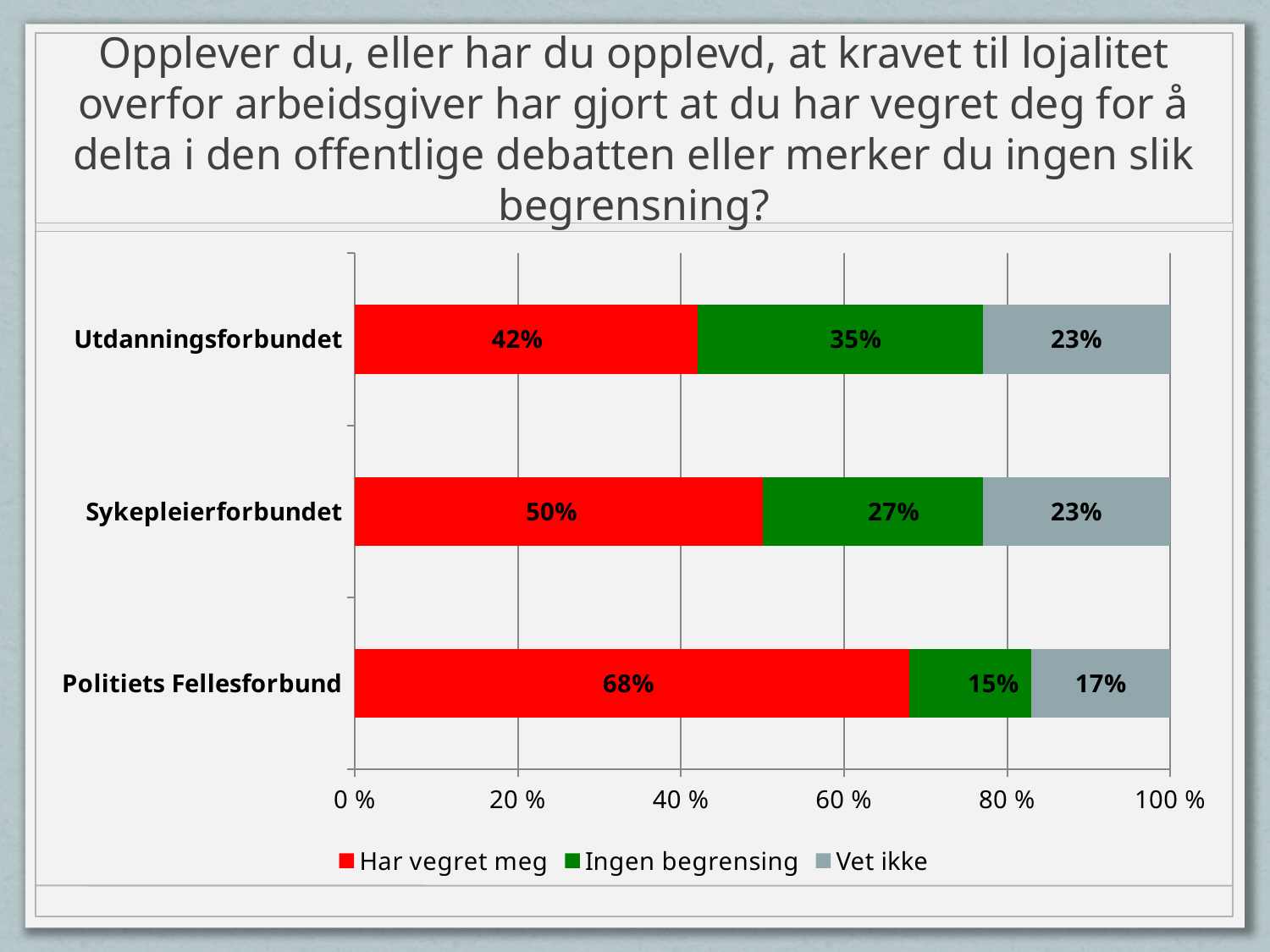
How many series does the legend list? 3 What is the total of the stacked bar for Politiets Fellesforbund? 100% Which category has the lowest value for "Ingen begrensing"? Politiets Fellesforbund Which category has the highest value for "Har vegret meg"? Politiets Fellesforbund What is the value for "Ingen begrensing" for Utdanningsforbundet? 35% What kind of chart is shown on the slide? Stacked bar chart How many categories are shown on the y axis? 3 Which colour represents the "Vet ikke" series? Grey What is the difference between the "Har vegret meg" values for Politiets Fellesforbund and Utdanningsforbundet? 26% Which is larger: "Ingen begrensing" for Sykepleierforbundet or "Ingen begrensing" for Utdanningsforbundet? Utdanningsforbundet What is the value for "Har vegret meg" for Politiets Fellesforbund? 68% What is the value for "Vet ikke" for Sykepleierforbundet? 23%